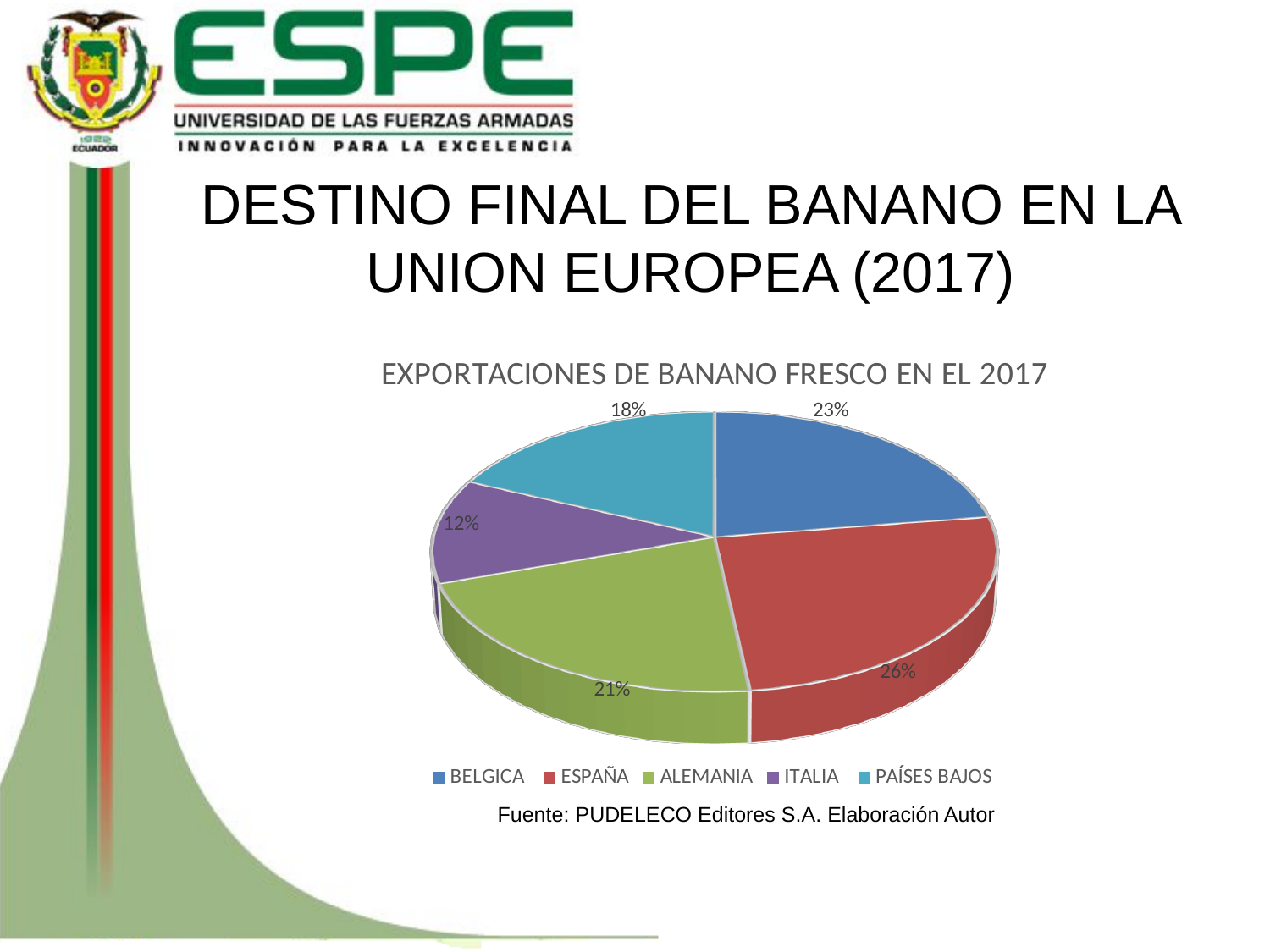
What is the value shown for ITALIA? 12% What share does BELGICA have in the pie chart? 23% What type of chart is shown on the slide? Pie chart Which country has the smallest slice of the pie chart? ITALIA What is the difference in percentage points between ESPAÑA and ITALIA? 14 What percentage of the pie chart corresponds to ESPAÑA? 26% What percentage is shown for PAÍSES BAJOS? 18% Which country has the largest slice of the pie chart? ESPAÑA Which has a larger share, ALEMANIA or PAÍSES BAJOS? ALEMANIA What is the title of the chart? EXPORTACIONES DE BANANO FRESCO EN EL 2017 What colour represents ALEMANIA in the pie chart? Green How many countries are shown in the pie chart? 5